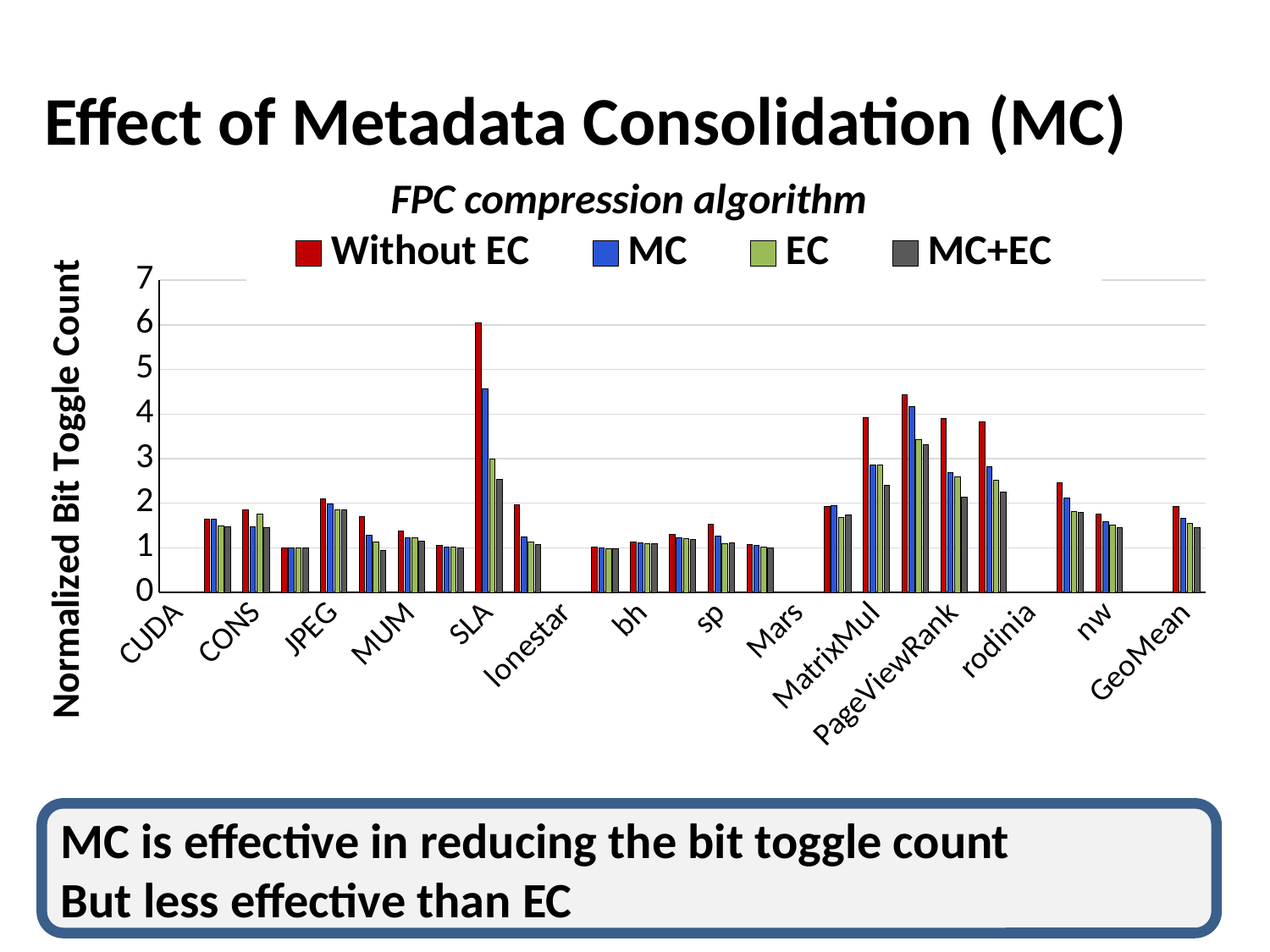
Which x-axis label has the tallest bar in the chart? SLA Which series has the tallest bar at SLA? Without EC What kind of chart is shown on the slide? bar chart Is the Without EC value at MatrixMul greater or less than 3? greater What is the title of the chart? FPC compression algorithm Is the Without EC value at SLA greater or less than 5? greater At SLA, which is larger: the Without EC bar or the EC bar? Without EC What is the label of the vertical axis? Normalized Bit Toggle Count Is the MC+EC value at GeoMean greater or less than 2? less How many series does the legend list? 4 At MatrixMul, which is larger: the MC bar or the MC+EC bar? MC